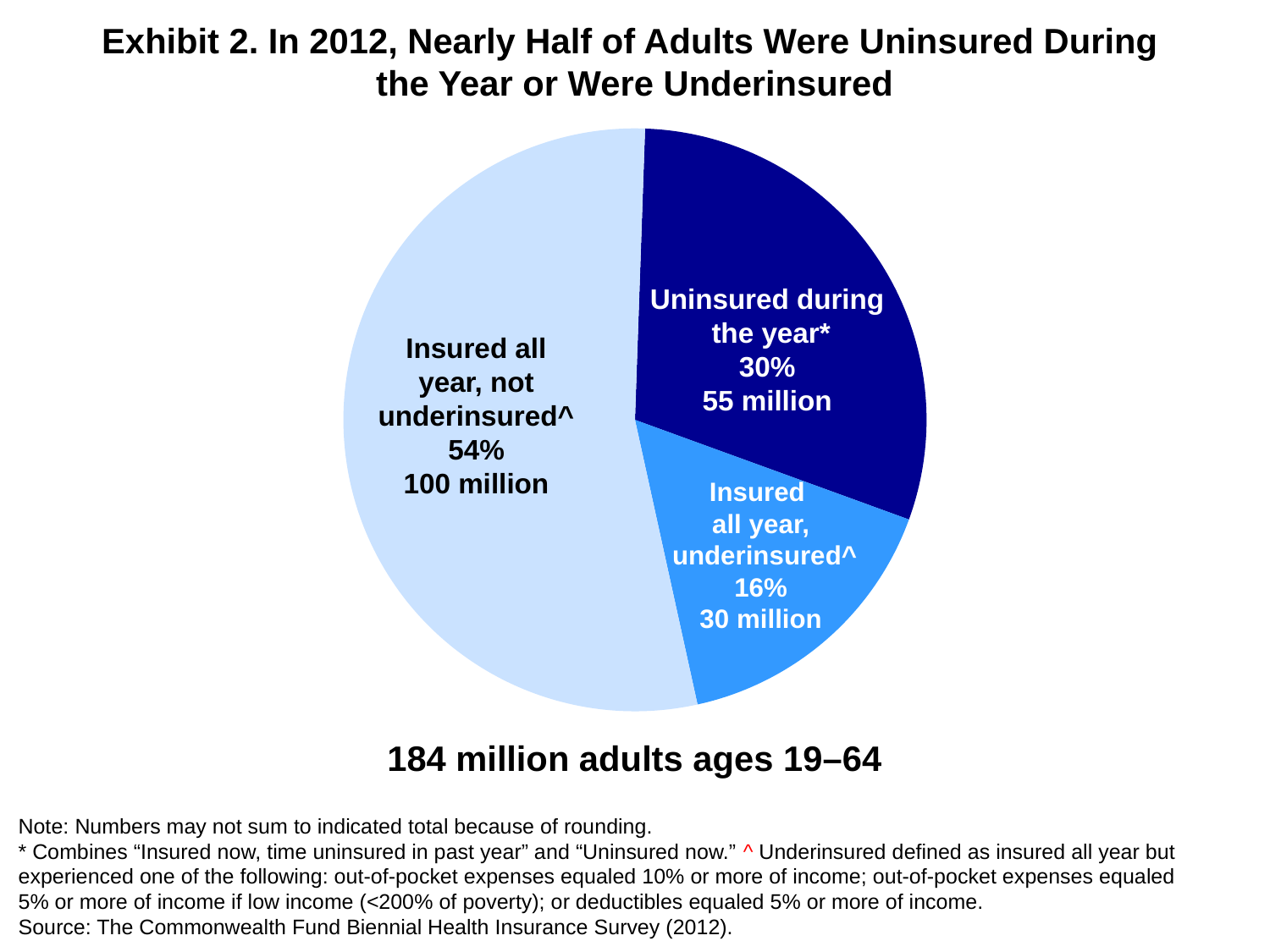
What percentage of adults were insured all year and not underinsured? 54% What percentage of adults were uninsured during the year? 30% What type of chart is shown on the slide? Pie chart Which is larger: the number of adults uninsured during the year or the number insured all year but underinsured? Uninsured during the year Which slice of the pie is the smallest? Insured all year, underinsured What is the difference in percentage points between the 'Insured all year, not underinsured' slice and the 'Uninsured during the year' slice? 24 percentage points How many adults were insured all year, not underinsured? 100 million What is the source of the data shown in the chart? The Commonwealth Fund Biennial Health Insurance Survey (2012) How many adults were insured all year but underinsured? 30 million How many slices does the pie chart have? 3 Which slice of the pie is the largest? Insured all year, not underinsured What is the total number of adults ages 19–64 represented by the pie chart? 184 million